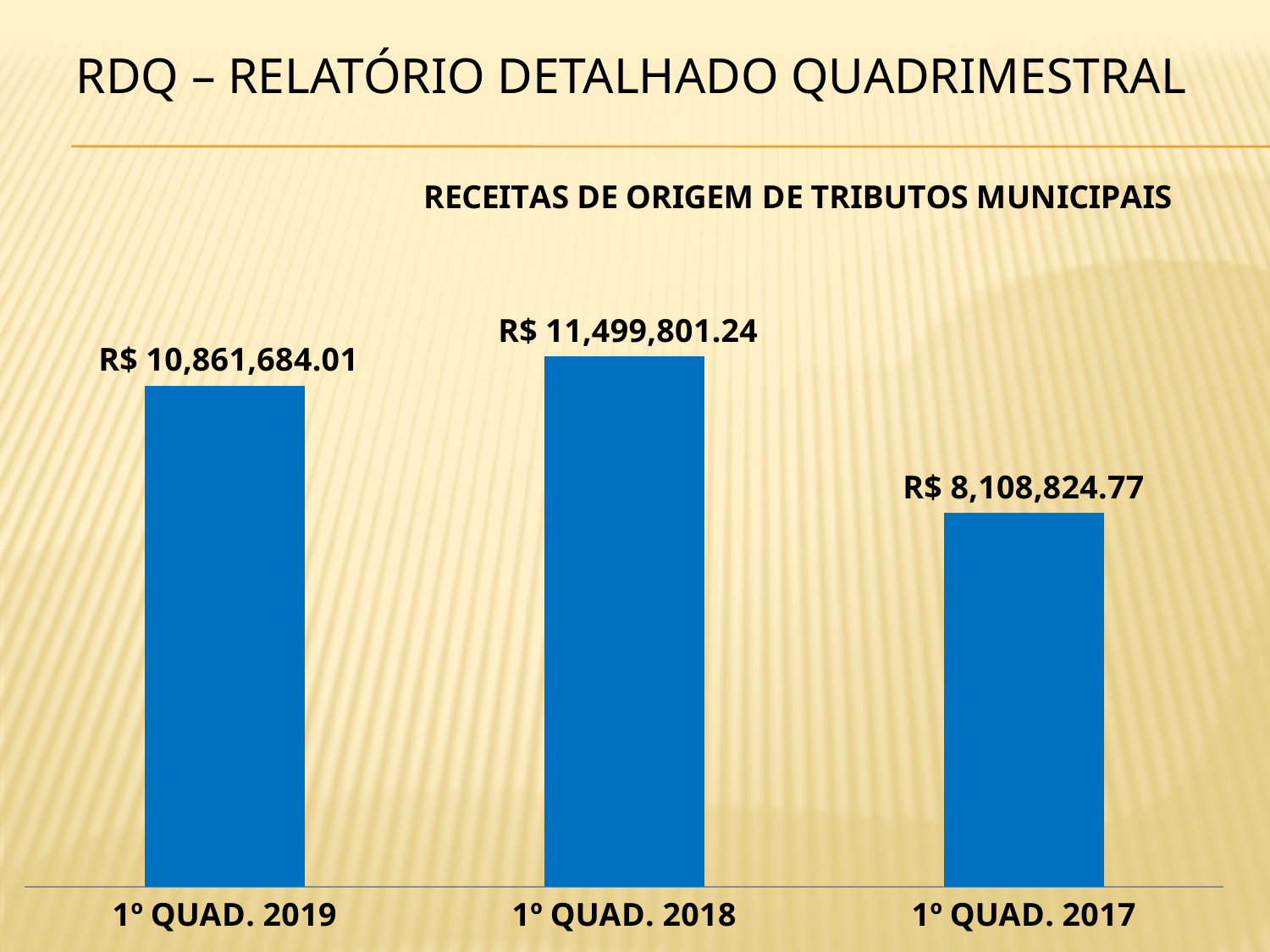
What is the value for 1º QUAD. 2019? R$ 10,861,684.01 Which period has the lowest value? 1º QUAD. 2017 What is the value for 1º QUAD. 2018? R$ 11,499,801.24 What is the value for 1º QUAD. 2017? R$ 8,108,824.77 Do the values rise or fall from 1º QUAD. 2018 to 1º QUAD. 2017 along the x axis? Fall What is the difference between the values for 1º QUAD. 2018 and 1º QUAD. 2019? R$ 638,117.23 Which is larger, the value for 1º QUAD. 2019 or for 1º QUAD. 2017? 1º QUAD. 2019 Which period has the highest value? 1º QUAD. 2018 What is the title of the chart? RECEITAS DE ORIGEM DE TRIBUTOS MUNICIPAIS What kind of chart is shown on the slide? Bar chart What is the difference between the values for 1º QUAD. 2019 and 1º QUAD. 2017? R$ 2,752,859.24 How many bars are shown in the chart? 3